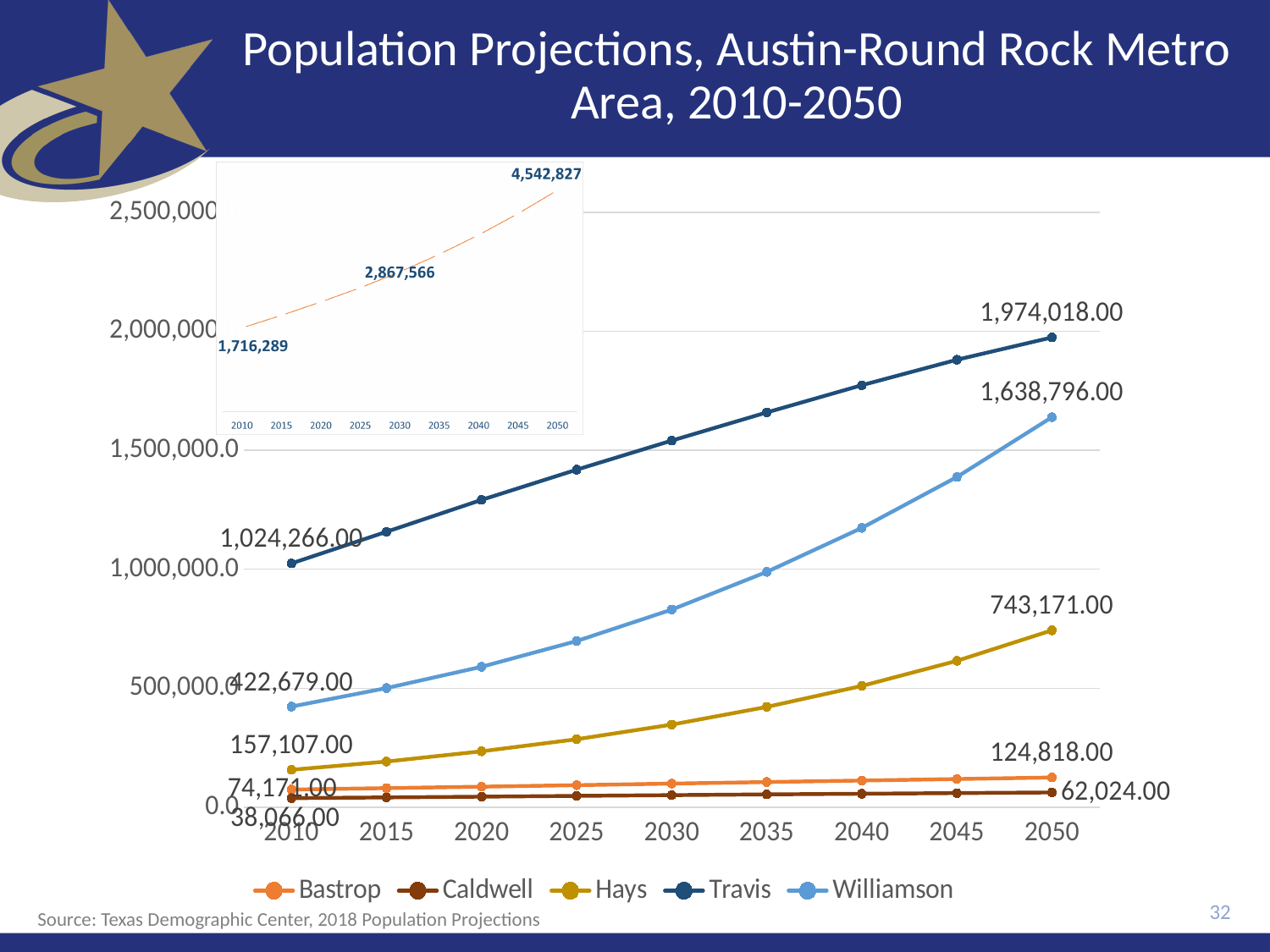
On the main chart, what is the projected population of Williamson in 2050? 1,638,796.00 On the main chart, what is the population of Hays in 2010? 157,107.00 What kind of chart is the main chart on the slide? line chart On the main chart, which county has the lowest population in 2010? Caldwell On the main chart, what is the difference between Travis's 2050 and 2010 populations? 949,752.00 On the main chart, what is the population of Caldwell in 2010? 38,066.00 How many series does the legend of the main chart list? 5 On the main chart, is the 2050 value for Bastrop larger or smaller than the 2050 value for Hays? smaller On the main chart, which county has the highest projected population in 2050? Travis On the main chart, what is the projected population of Travis in 2050? 1,974,018.00 On the inset chart in the top-left, what is the value labelled for 2050? 4,542,827